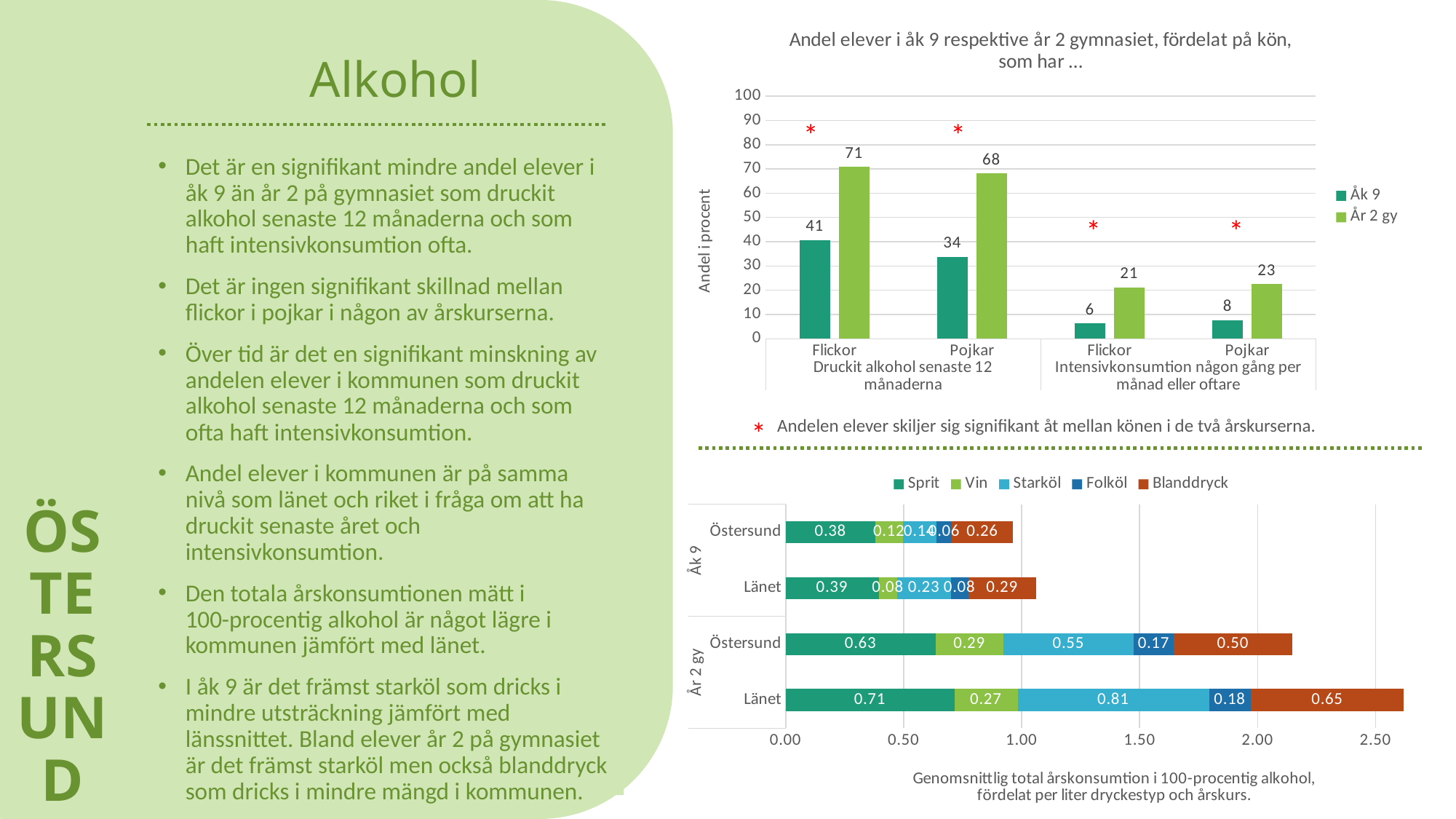
In the top chart, which is larger: the Åk 9 value for Pojkar or for Flickor with intensivkonsumtion? Pojkar In the bottom chart, what is the difference between the Sprit values for Länet and Östersund in År 2 gy? 0.08 In the bottom chart, what is the Starköl value for Länet in År 2 gy? 0.81 How many series does the legend of the top chart list? 2 In the bottom chart, what is the total of the stacked bar for Länet in År 2 gy? 2.62 How many series does the legend of the bottom chart list? 5 In the top chart, what is the value for År 2 gy among Pojkar who druckit alkohol senaste 12 månaderna? 68 In the bottom chart, what is the Blanddryck value for Östersund in År 2 gy? 0.50 What type of chart is the top chart? Bar chart In the top chart, what is the value for Åk 9 among Flickor who druckit alkohol senaste 12 månaderna? 41 In the top chart, what is the difference between År 2 gy and Åk 9 for Flickor with intensivkonsumtion någon gång per månad eller oftare? 15 In the top chart, which bar has the highest value? År 2 gy, Flickor, Druckit alkohol senaste 12 månaderna (71)